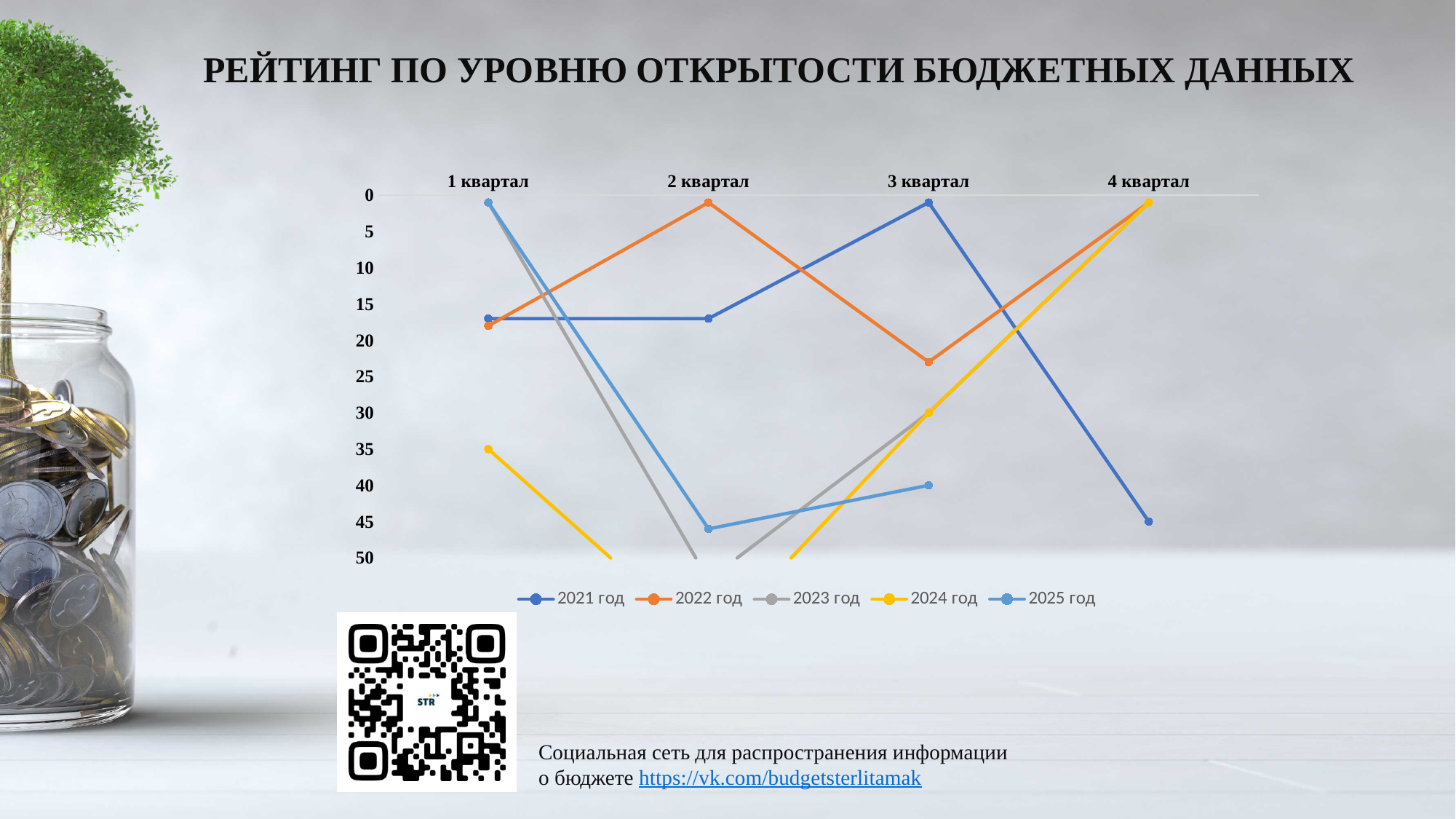
Which series is shown in orange in the legend? 2022 год How many series does the legend list? 5 Is the value for 2022 год in 3 квартал greater or less than 20? greater Is the value for 2025 год in 2 квартал greater or less than 40? greater In 4 квартал, which series has the highest value? 2021 год What is the title of the chart? РЕЙТИНГ ПО УРОВНЮ ОТКРЫТОСТИ БЮДЖЕТНЫХ ДАННЫХ What kind of chart is shown on the slide? line chart Is the value for 2021 год in 4 квартал greater or less than 40? greater How many categories are shown on the x axis? 4 In 4 квартал, which is larger: the value for 2021 год or the value for 2022 год? 2021 год